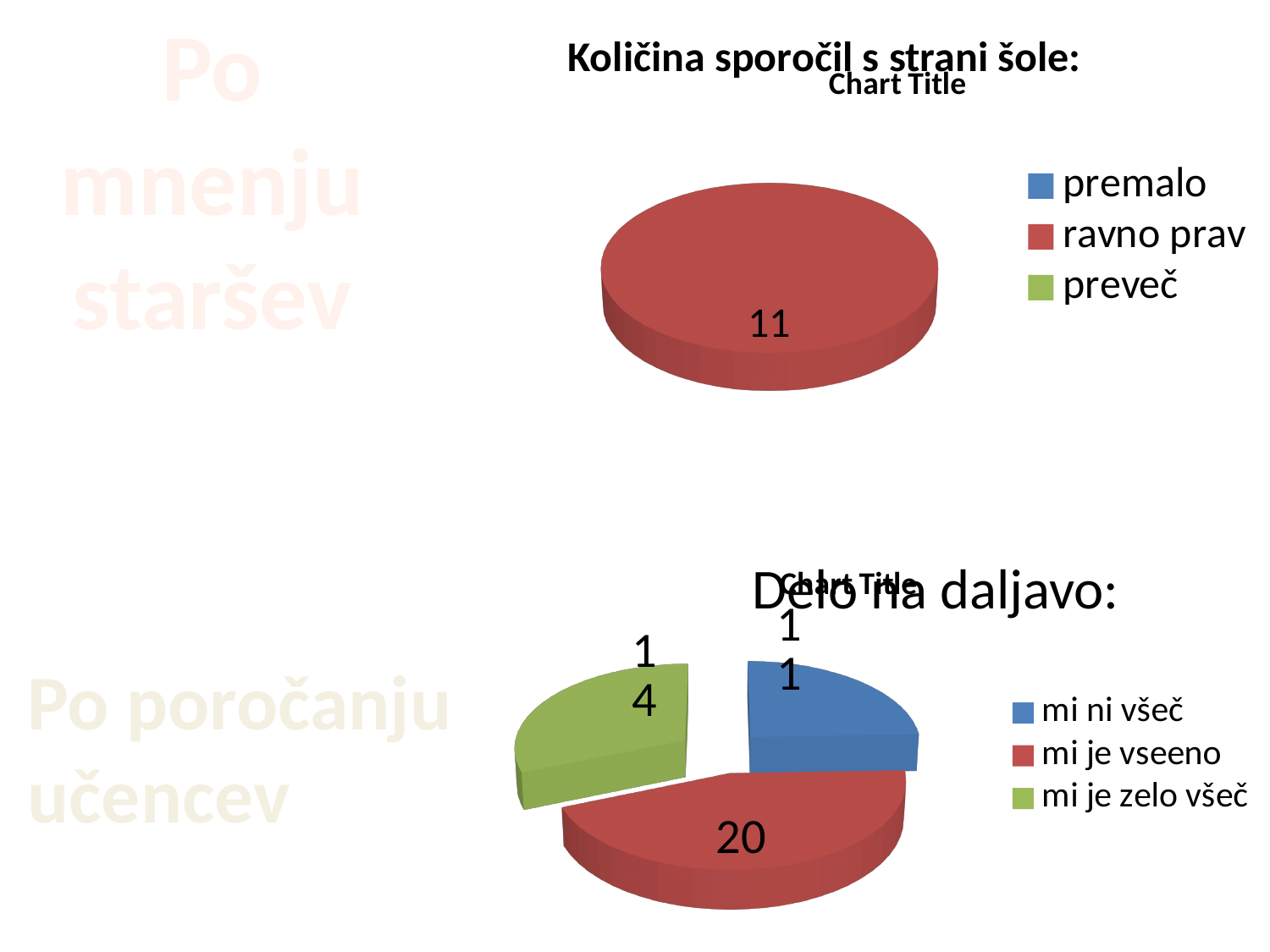
In the bottom chart (Delo na daljavo), which category has the largest slice? mi je vseeno In the top chart (Količina sporočil s strani šole), what value is shown for the 'ravno prav' slice? 11 How many entries does the legend of the top chart (Količina sporočil s strani šole) list? 3 In the bottom chart (Delo na daljavo), what value is shown for 'mi je vseeno'? 20 In the bottom chart (Delo na daljavo), what colour is the 'mi je zelo všeč' slice? green What type of chart is the top chart (Količina sporočil s strani šole)? pie chart In the bottom chart (Delo na daljavo), which is larger: 'mi je vseeno' or 'mi ni všeč'? mi je vseeno In the bottom chart (Delo na daljavo), what value is shown for 'mi ni všeč'? 11 In the bottom chart (Delo na daljavo), what is the difference between the values for 'mi je vseeno' and 'mi je zelo všeč'? 6 In the bottom chart (Delo na daljavo), what value is shown for 'mi je zelo všeč'? 14 In the top chart (Količina sporočil s strani šole), which category makes up the entire pie? ravno prav In the bottom chart (Delo na daljavo), which category has the smallest slice? mi ni všeč